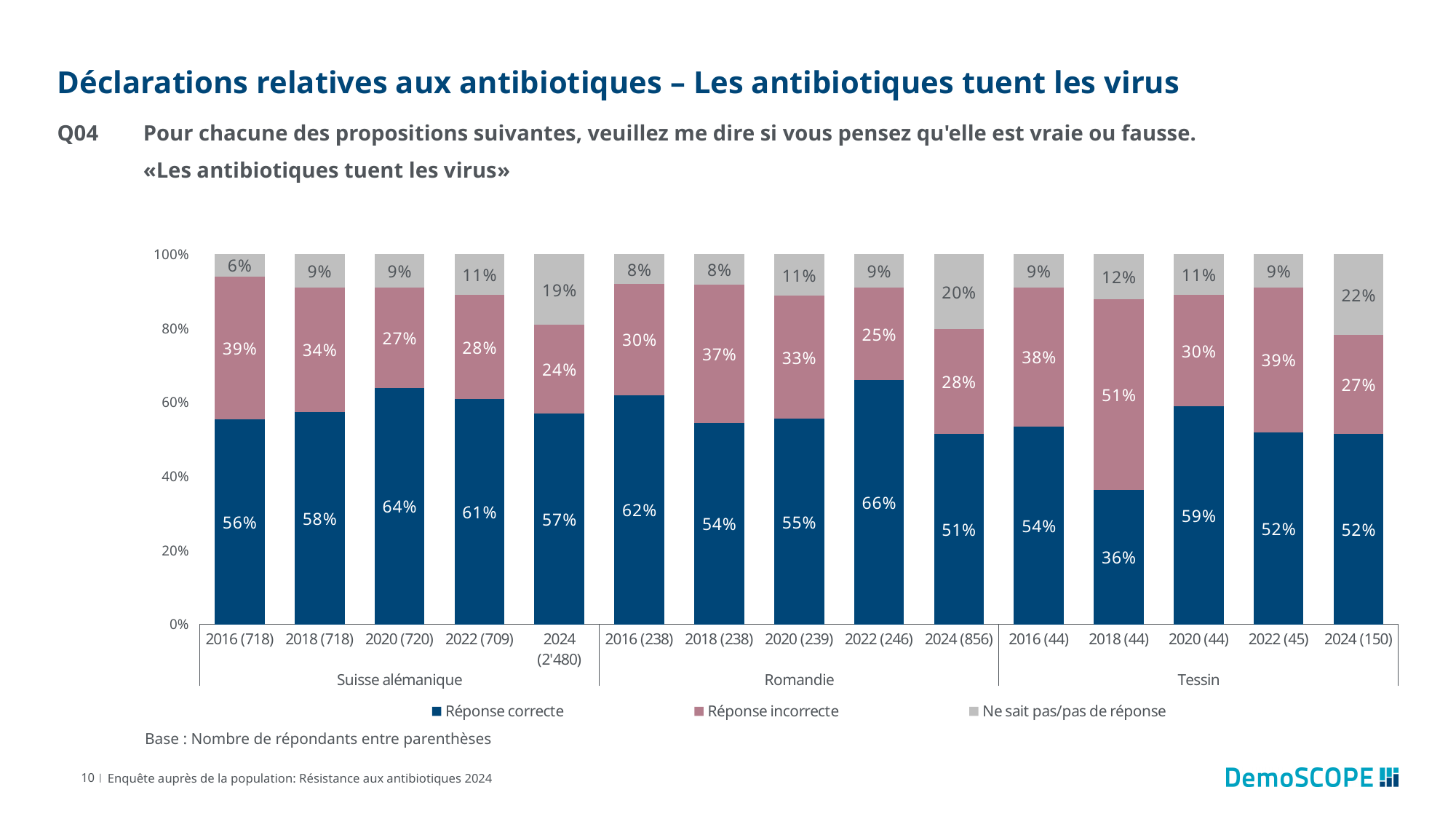
How many series does the legend list? 3 What is the value of "Ne sait pas/pas de réponse" for Romandie in 2024 (856)? 20% Which bar has the highest value for "Réponse correcte"? Romandie 2022 (246) How many bars are plotted in the chart? 15 Which legend entry is shown in dark blue? Réponse correcte What is the value of "Réponse correcte" for Suisse alémanique in 2020 (720)? 64% Which bar has the highest value for "Ne sait pas/pas de réponse"? Tessin 2024 (150) What kind of chart is shown on the slide? Stacked bar chart What is the difference between the "Réponse correcte" values for Suisse alémanique in 2020 (720) and 2024 (2'480)? 7 percentage points Which is larger: "Réponse incorrecte" for Romandie in 2018 (238) or for Tessin in 2020 (44)? Romandie 2018 (238) Which bar has the lowest value for "Réponse correcte"? Tessin 2018 (44) What is the value of "Réponse incorrecte" for Tessin in 2018 (44)? 51%